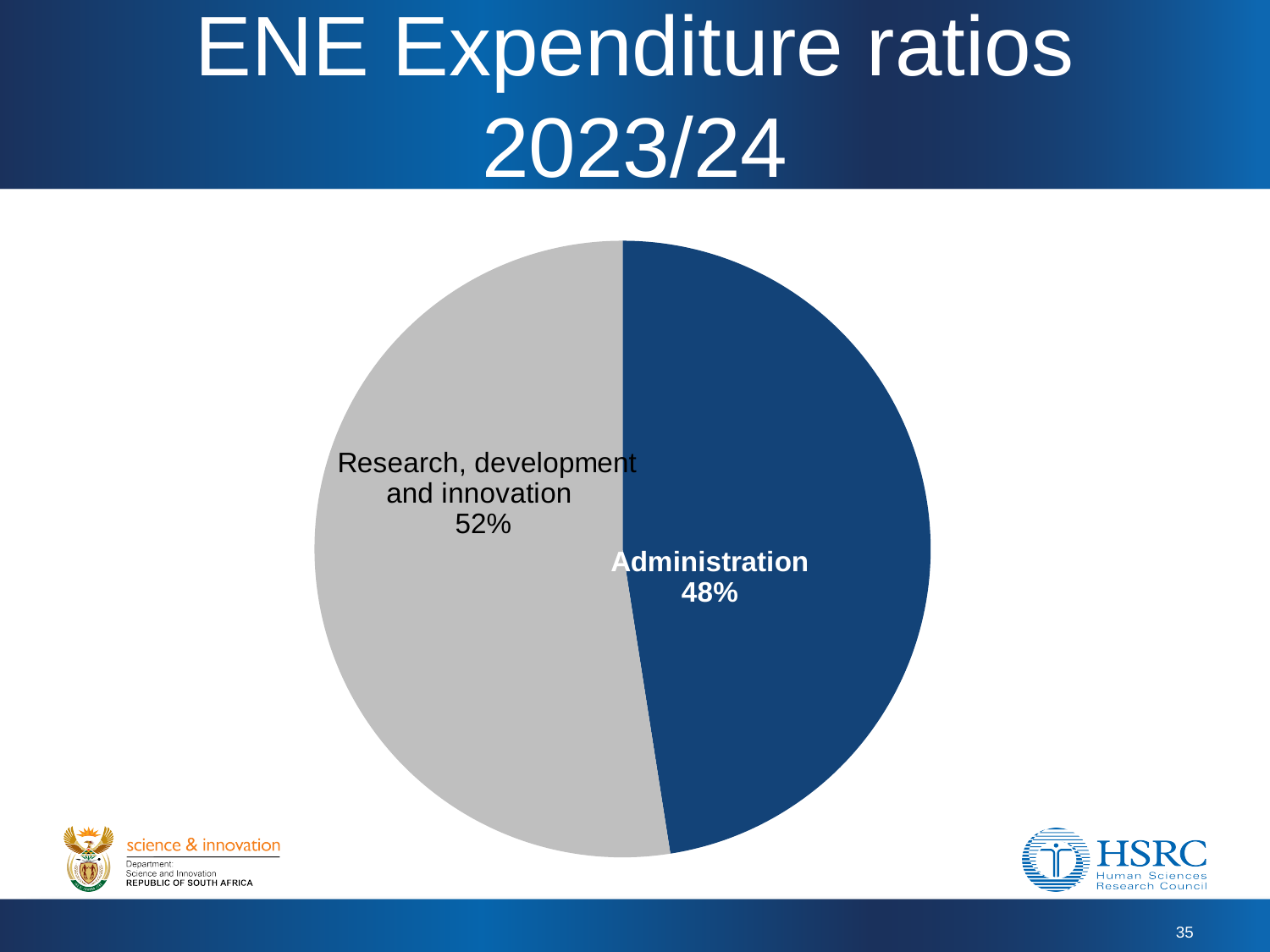
Which is larger, the Administration slice or the Research, development and innovation slice? Research, development and innovation Which slice is the largest? Research, development and innovation Which slice is the smallest? Administration What is the difference in percentage points between the Research, development and innovation slice and the Administration slice? 4 What share of the pie does Administration represent? 48% What is the title of the slide containing the chart? ENE Expenditure ratios 2023/24 What share of the pie does Research, development and innovation represent? 52% What colour is the Administration slice? blue What is the total of the two slice percentages shown? 100% How many slices does the pie chart have? 2 What kind of chart is shown on the slide? pie chart